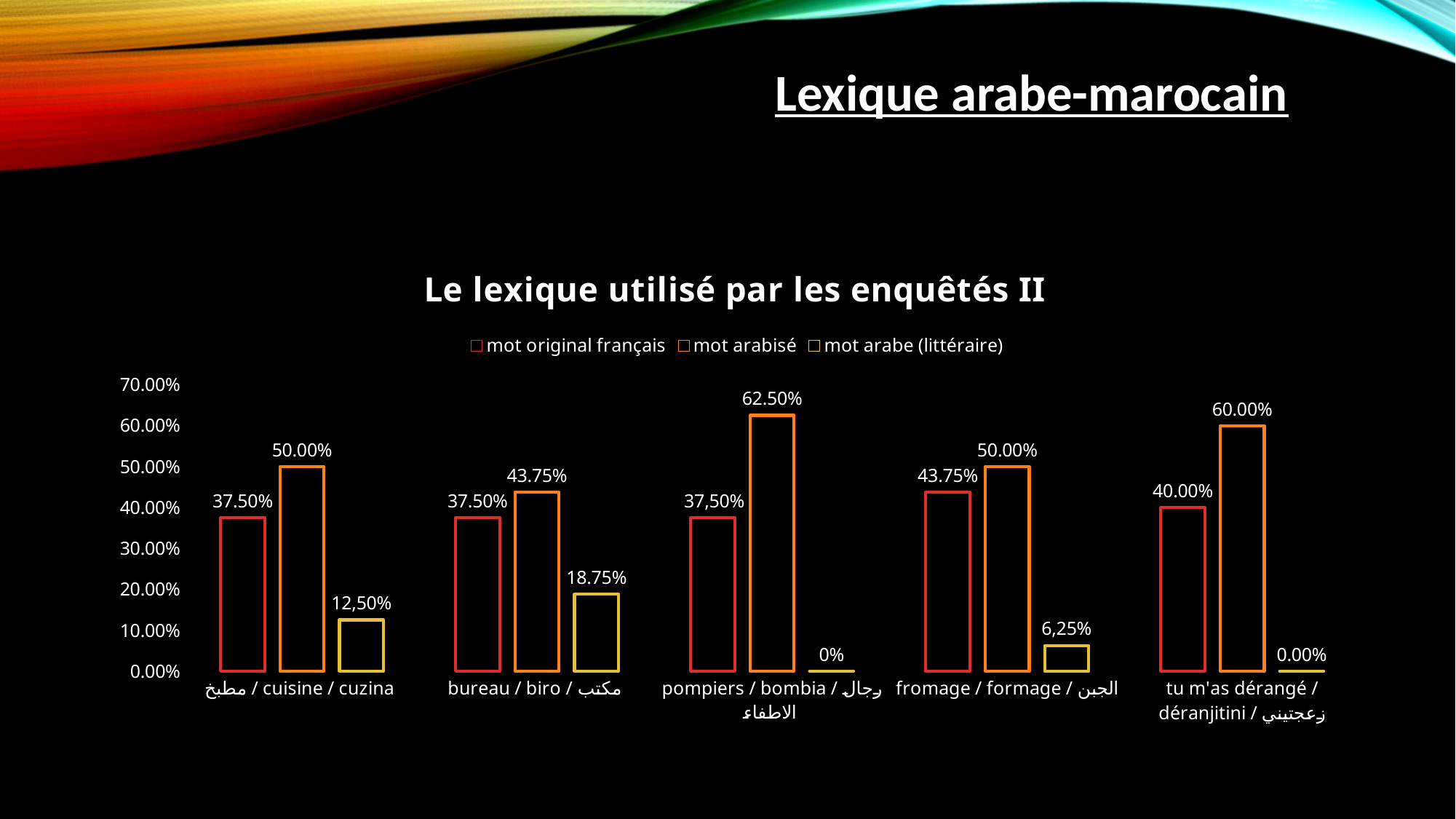
What is the value of 'mot arabisé' for the category 'pompiers / bombia'? 62.50% What is the value of 'mot original français' for the category 'fromage / formage'? 43.75% How many series does the legend list? 3 What is the title of the chart? Le lexique utilisé par les enquêtés II What type of chart is shown on the slide? bar chart What is the value of 'mot arabe (littéraire)' for the category 'bureau / biro'? 18.75% What is the difference between 'mot arabisé' and 'mot original français' for the category 'tu m'as dérangé / déranjitini'? 20.00% How many categories are shown on the x axis? 5 What is the value of 'mot arabe (littéraire)' for the category 'tu m'as dérangé / déranjitini'? 0.00% Which category has the highest value for 'mot arabe (littéraire)'? bureau / biro Which category has the highest value for 'mot arabisé'? pompiers / bombia For the category 'cuisine / cuzina', which is larger: 'mot original français' or 'mot arabisé'? mot arabisé